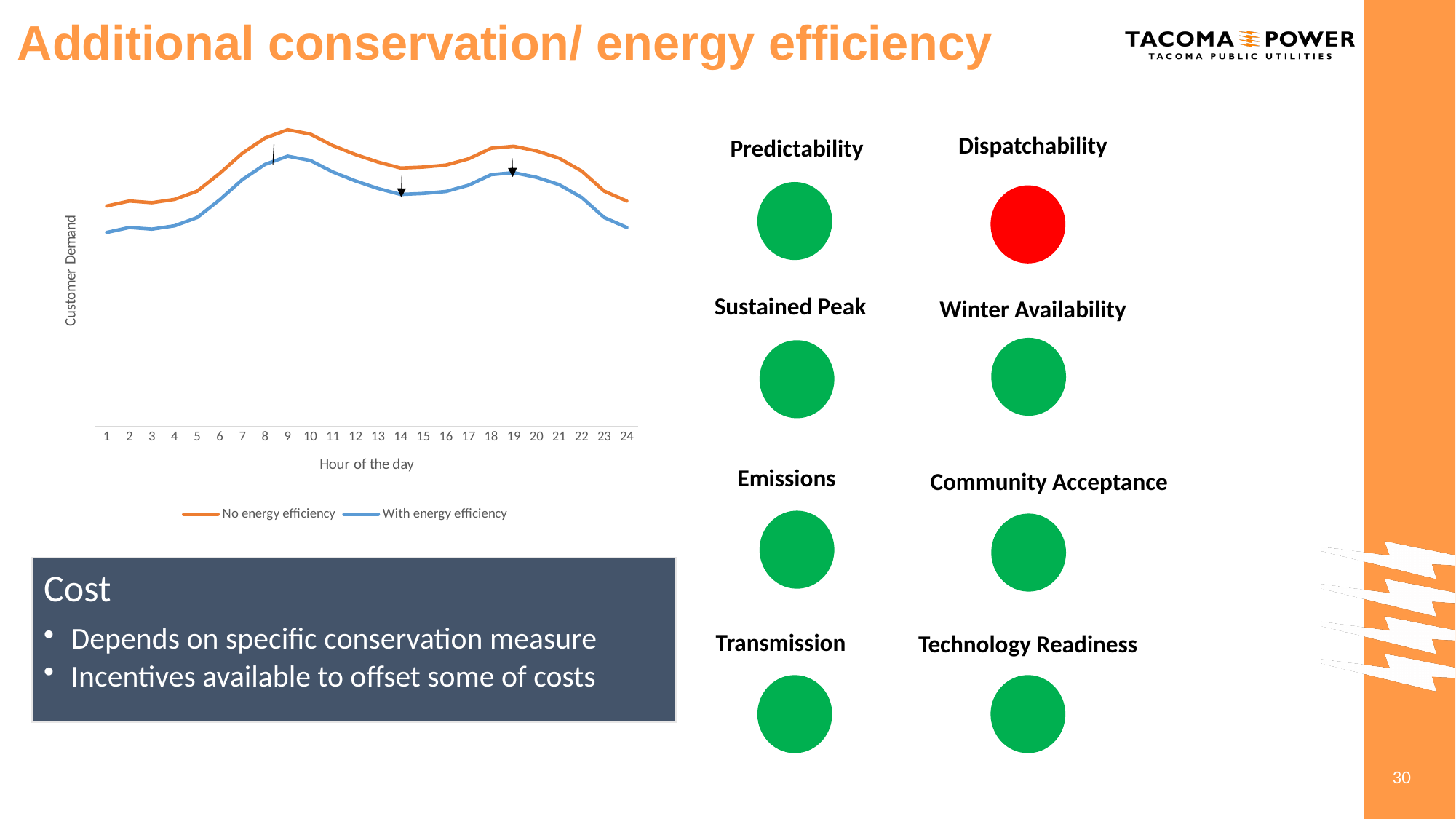
How many hours are plotted along the x axis of the line chart? 24 At which hour of the day does the 'No energy efficiency' line reach its highest point? 9 At which hour of the day does the 'With energy efficiency' line reach its highest point? 9 At hour 19, which series shows lower customer demand: 'No energy efficiency' or 'With energy efficiency'? With energy efficiency At hour 14, which series shows higher customer demand: 'No energy efficiency' or 'With energy efficiency'? No energy efficiency What kind of chart is shown on the left of the slide? line chart Does customer demand for the 'With energy efficiency' series rise or fall from hour 19 to hour 24? fall What are the two series named in the legend of the line chart? No energy efficiency; With energy efficiency Does customer demand for the 'No energy efficiency' series rise or fall from hour 9 to hour 14? fall Does customer demand for the 'No energy efficiency' series rise or fall from hour 5 to hour 9? rise How many series does the legend of the line chart list? 2 What is the x-axis title of the line chart? Hour of the day